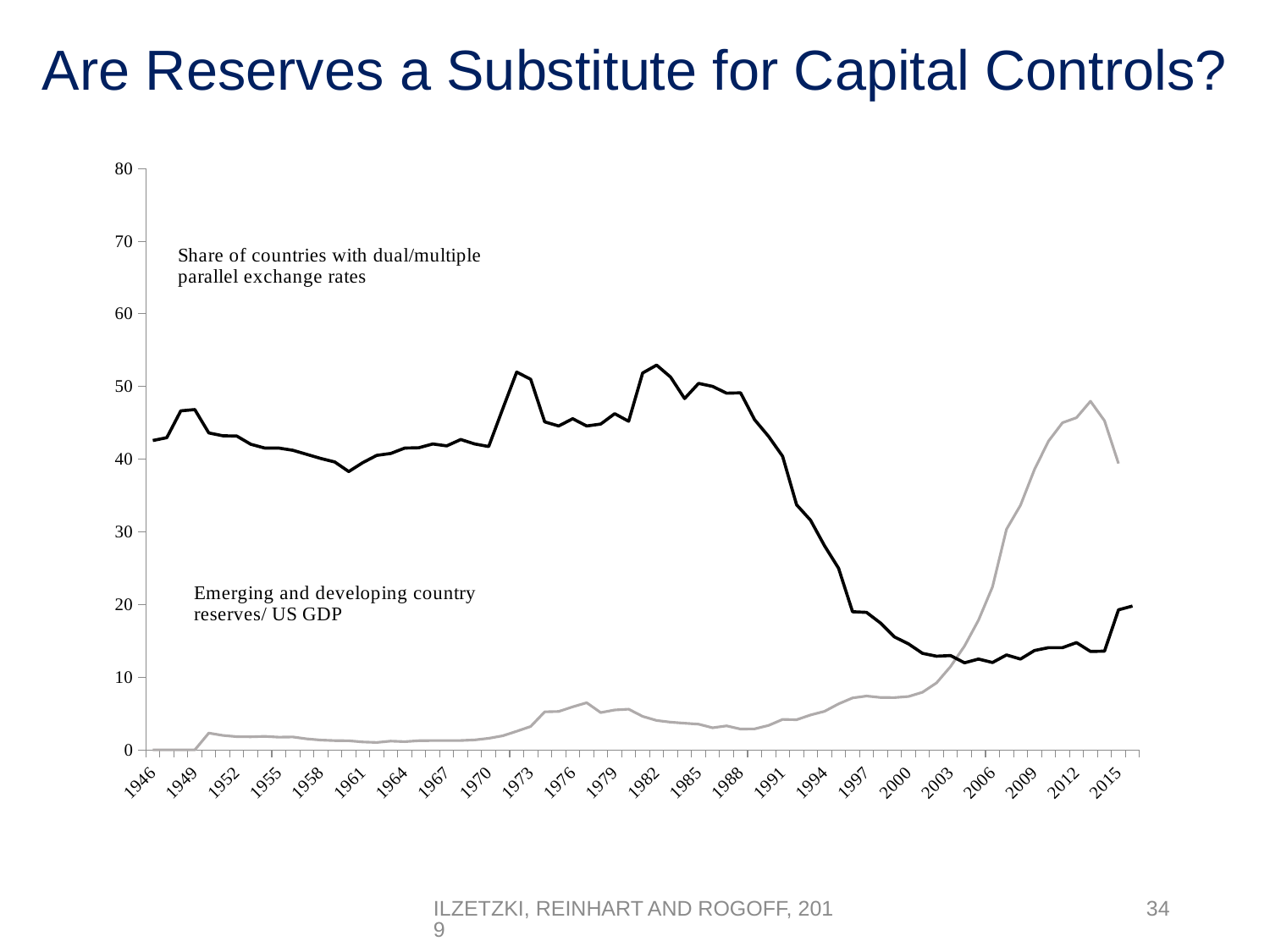
Is the value of 'Share of countries with dual/multiple parallel exchange rates' in 2006 greater or less than 20? less Does the 'Share of countries with dual/multiple parallel exchange rates' line rise or fall between 1988 and 2000? fall Is the value of 'Emerging and developing country reserves/ US GDP' in 2015 greater or less than 30? greater How many data series are plotted on the chart? 2 What colour is the line for 'Emerging and developing country reserves/ US GDP'? grey Is the value of 'Emerging and developing country reserves/ US GDP' in 1970 greater or less than 10? less What kind of chart is shown on the slide? line chart In 2012, which series has the higher value: 'Share of countries with dual/multiple parallel exchange rates' or 'Emerging and developing country reserves/ US GDP'? Emerging and developing country reserves/ US GDP In 1985, which series has the higher value: 'Share of countries with dual/multiple parallel exchange rates' or 'Emerging and developing country reserves/ US GDP'? Share of countries with dual/multiple parallel exchange rates What is the title of the slide containing the chart? Are Reserves a Substitute for Capital Controls?